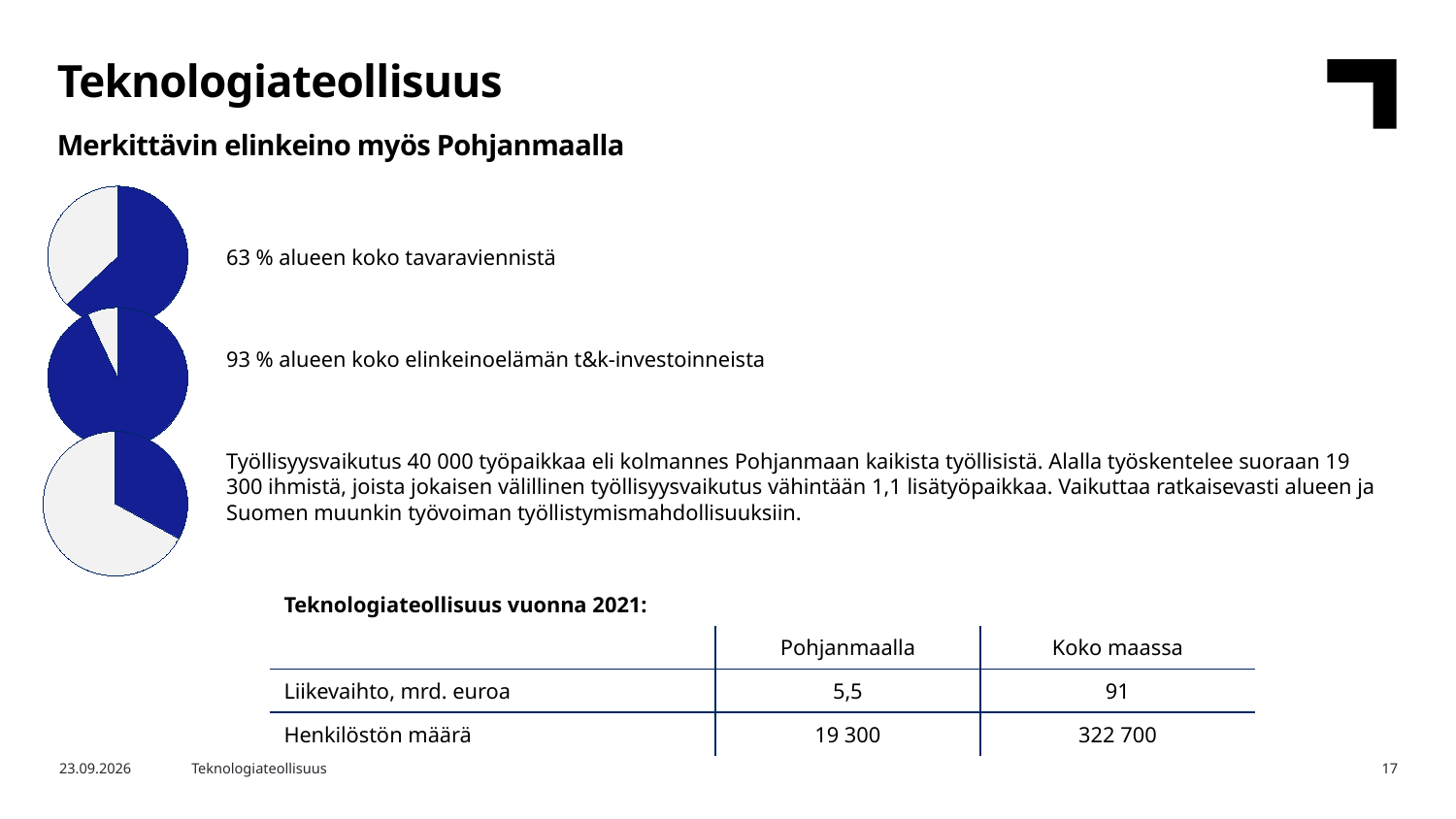
In the top pie chart, what share does the highlighted (blue) slice represent? 63 % What kind of charts are shown on the left side of the slide? pie charts Is the highlighted (blue) share in the middle pie chart greater or less than 75 %? greater Which of the three pie charts has the largest highlighted (blue) share? the middle one (93 %) In the middle pie chart, what share does the highlighted (blue) slice represent? 93 % Which has a larger highlighted (blue) share, the top pie chart or the bottom pie chart? the top pie chart What does the 63 % share in the top pie chart refer to? alueen koko tavaraviennistä Which of the three pie charts has the smallest highlighted (blue) share? the bottom one What colour is the highlighted slice in each pie chart? dark blue Is the highlighted (blue) share in the bottom pie chart greater or less than 50 %? less What does the 93 % share in the middle pie chart refer to? alueen koko elinkeinoelämän t&k-investoinneista How many pie charts are on the slide? 3